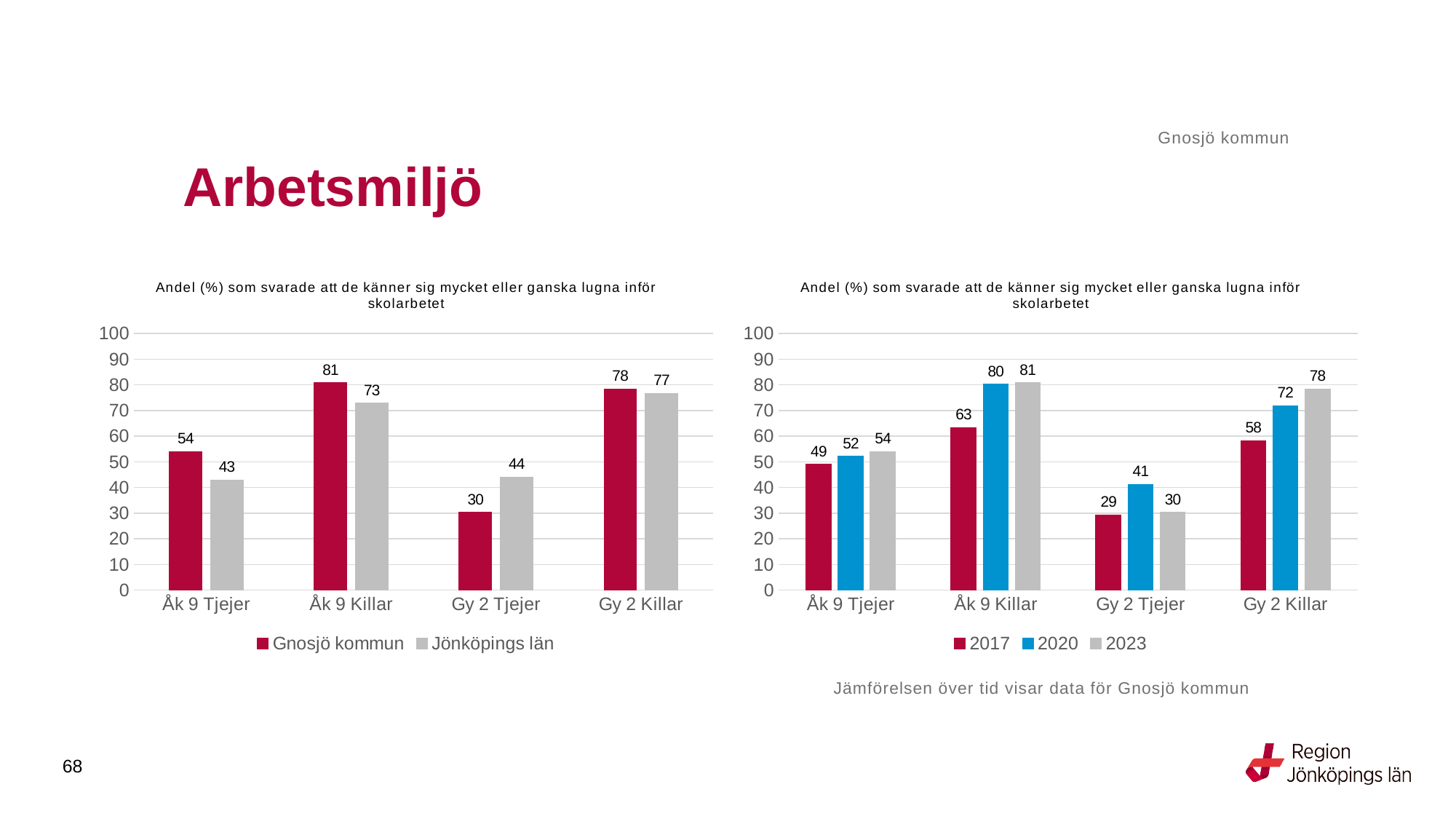
In the right chart, how many series does the legend list? 3 In the left chart, what is the value for Gnosjö kommun for Åk 9 Killar? 81 In the right chart, what is the difference between 2023 and 2017 for Gy 2 Killar? 20 In the right chart, what is the value for 2017 for Åk 9 Killar? 63 In the left chart, which is larger for Gy 2 Tjejer: Gnosjö kommun or Jönköpings län? Jönköpings län What kind of chart is the right chart? Bar chart In the left chart, what is the value for Jönköpings län for Gy 2 Tjejer? 44 In the right chart, what is the value for 2020 for Gy 2 Tjejer? 41 In the left chart, what is the difference between Gnosjö kommun and Jönköpings län for Åk 9 Tjejer? 11 In the left chart, how many series does the legend list? 2 In the right chart, which category has the highest value for 2023? Åk 9 Killar In the left chart, which category has the lowest value for Gnosjö kommun? Gy 2 Tjejer